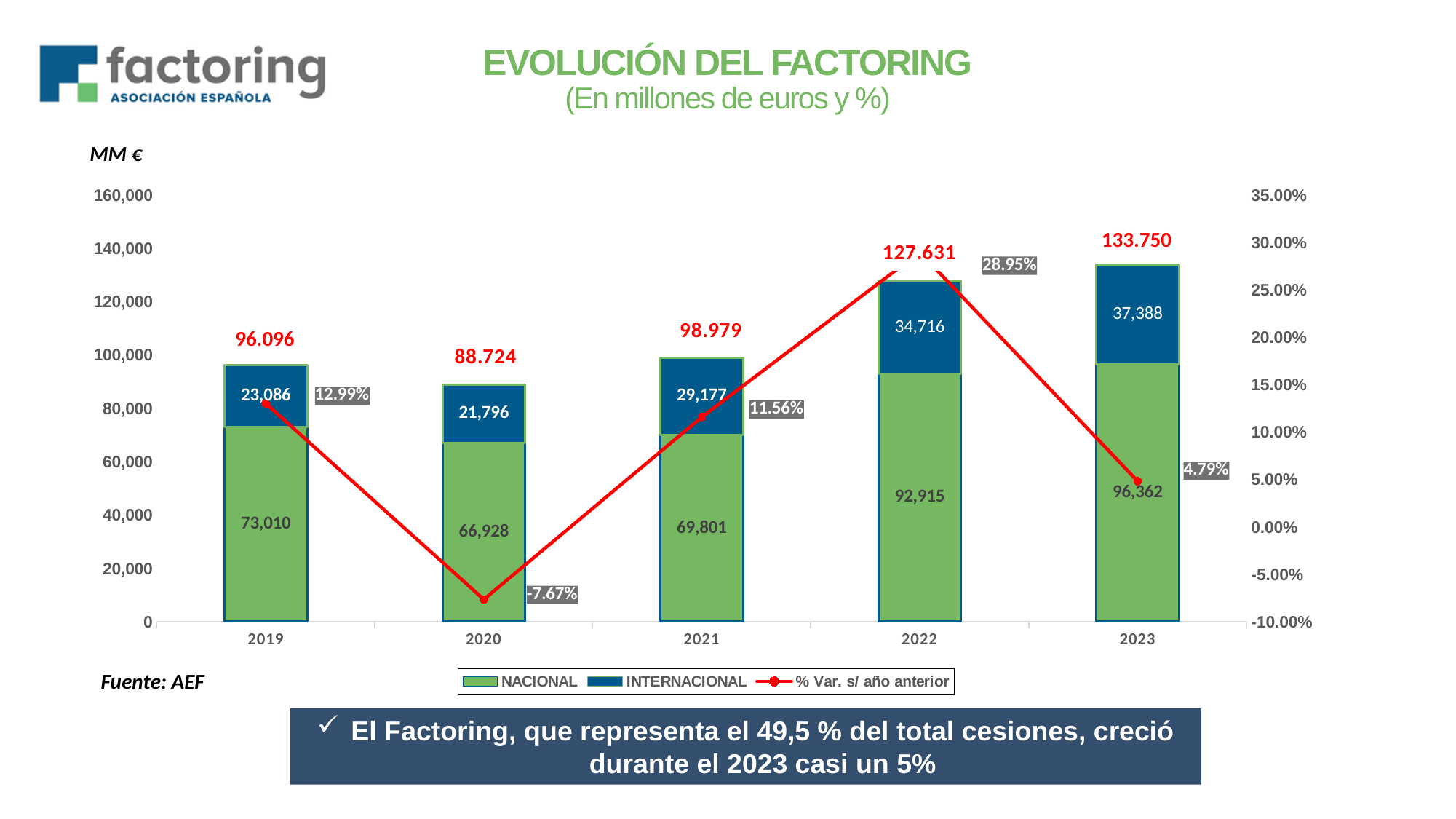
What is the difference between the INTERNACIONAL values for 2023 and 2022? 2,672 Which year has the highest % Var. s/ año anterior? 2022 What is the % Var. s/ año anterior value for 2020? -7.67% How many series does the legend list? 3 Which year has the lowest NACIONAL value? 2020 What is the total factoring value labelled above the 2023 bar? 133.750 How many years are shown on the x axis? 5 What is the NACIONAL value for 2019? 73,010 What is the INTERNACIONAL value for 2022? 34,716 Does the % Var. s/ año anterior line rise or fall from 2022 to 2023? fall Which year has the larger NACIONAL value, 2019 or 2021? 2019 What is the difference between the NACIONAL values for 2022 and 2021? 23,114